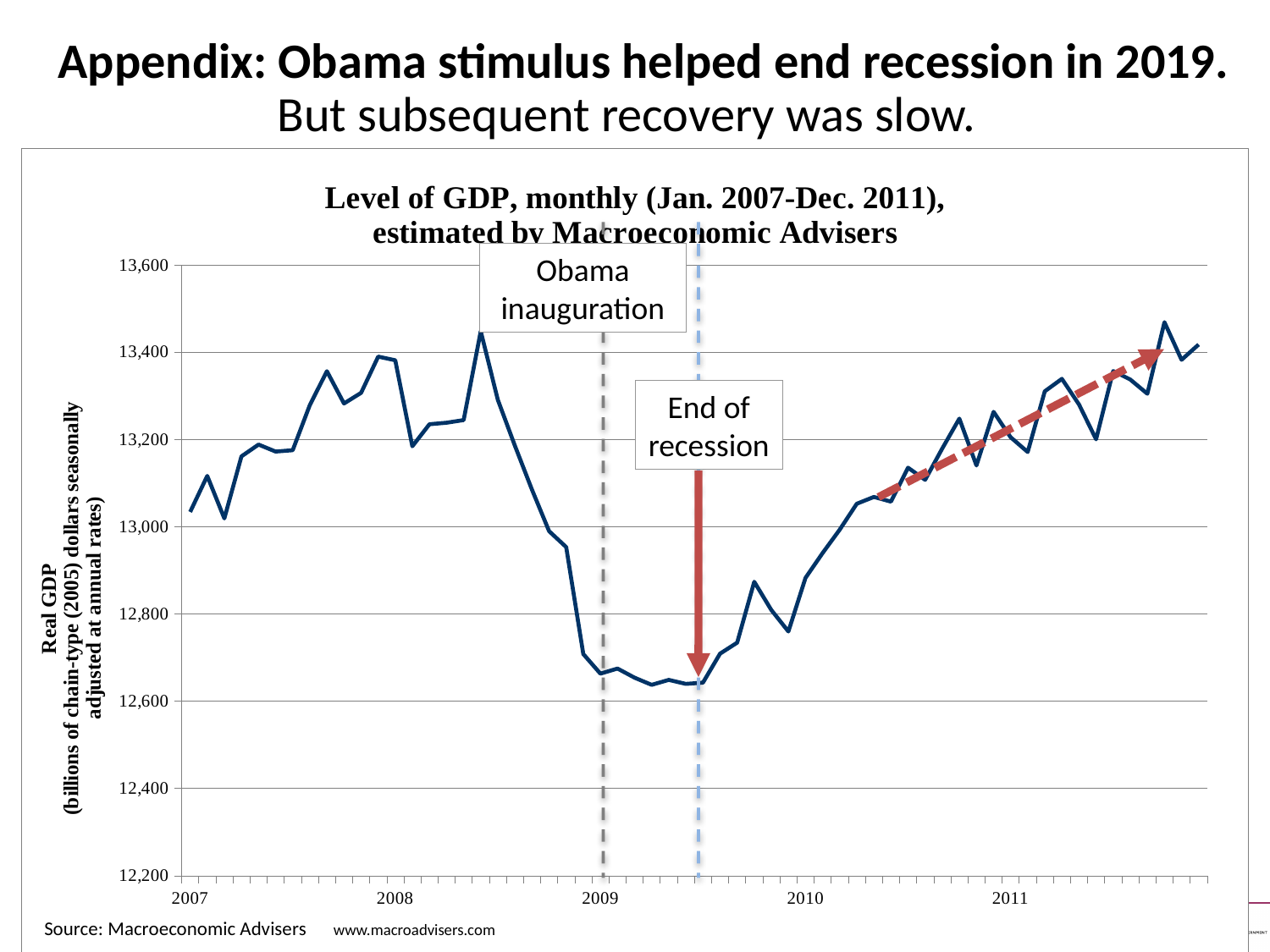
In which year does the line reach its lowest point? 2009 What is the title of the chart? Level of GDP, monthly (Jan. 2007-Dec. 2011), estimated by Macroeconomic Advisers Does GDP rise or fall between mid-2008 and the start of 2009? fall How many year labels appear on the x axis? 5 Which is larger: GDP at the start of 2008 or GDP at the 'End of recession' point? start of 2008 Does GDP rise or fall between the start of 2010 and the end of 2011? rise What kind of chart is shown on the slide? line chart Is the value of GDP at the point marked 'End of recession' greater or less than 12,800? less What are the two annotated events marked by dashed vertical lines on the chart? Obama inauguration and End of recession Is the value of GDP at the start of 2007 greater or less than 12,800? greater What is the highest value shown on the y axis? 13,600 Is the value of GDP at the end of 2011 greater or less than 13,200? greater